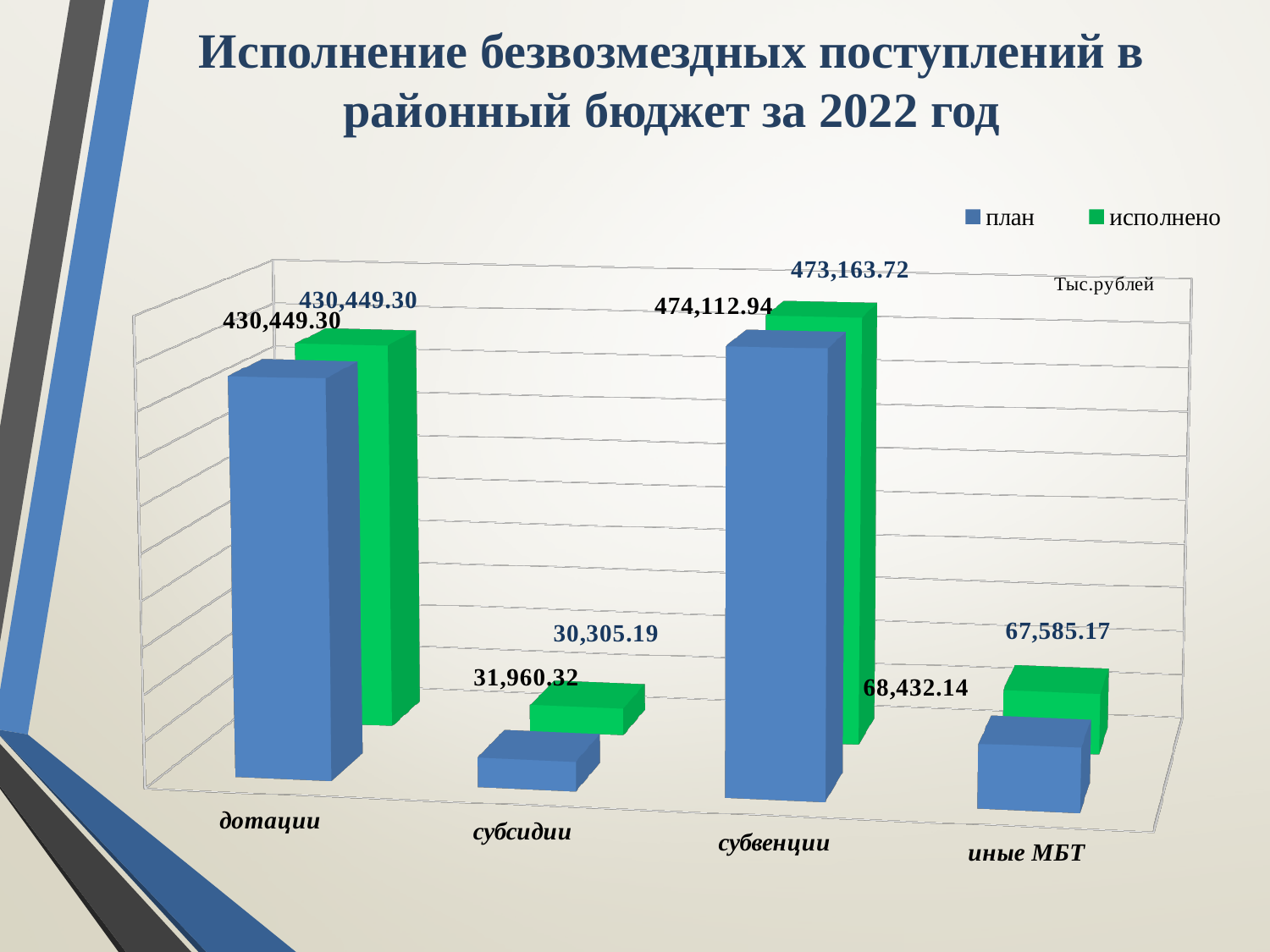
What is the план value for дотации? 430,449.30 Which is larger for субвенции, the план value or the исполнено value? план What is the исполнено value for субсидии? 30,305.19 What kind of chart is shown on the slide? bar chart Which category has the highest план value? субвенции What is the план value for субвенции? 474,112.94 What is the difference between the план and исполнено values for иные МБТ? 846.97 How many series does the legend list? 2 What is the difference between the план and исполнено values for субсидии? 1,655.13 How many categories are shown on the x axis? 4 Which category has the lowest исполнено value? субсидии What is the исполнено value for иные МБТ? 67,585.17